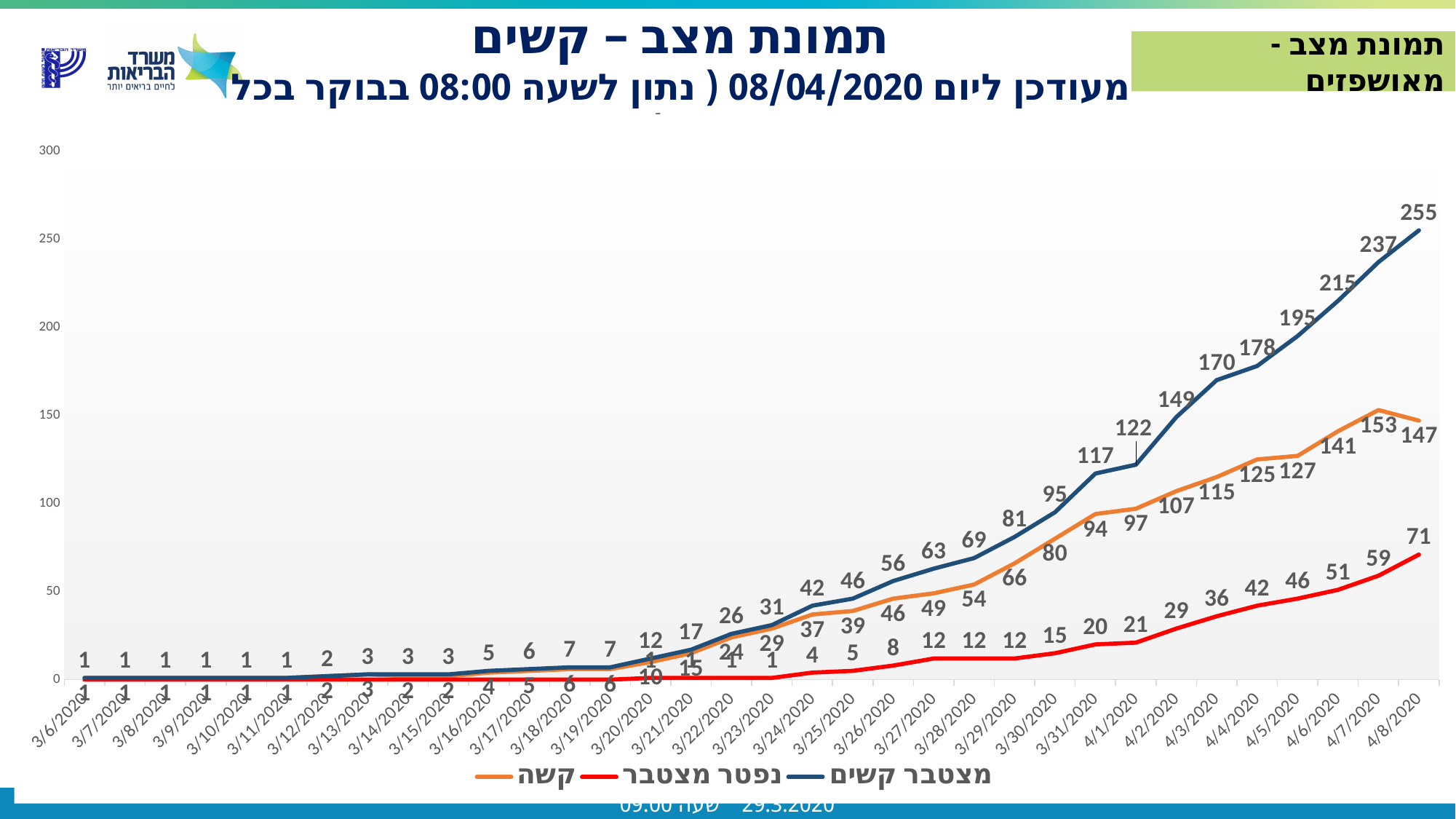
What is the difference between the מצטבר קשים value and the קשה value on 4/8/2020? 108 What is the value of the נפטר מצטבר series on 3/31/2020? 20 Is the value of the מצטבר קשים series on 4/1/2020 greater or less than 100? greater What kind of chart is shown on the slide? line chart Does the מצטבר קשים series rise or fall from 3/6/2020 to 4/8/2020? rise How many series does the legend list? 3 What is the value of the מצטבר קשים series on 4/8/2020? 255 What is the value of the נפטר מצטבר series on 4/8/2020? 71 By how much did the מצטבר קשים series increase from 4/7/2020 to 4/8/2020? 18 On which date does the קשה series reach its highest value? 4/7/2020 On 4/8/2020, which series has the larger value, קשה or נפטר מצטבר? קשה What is the value of the קשה series on 4/7/2020? 153